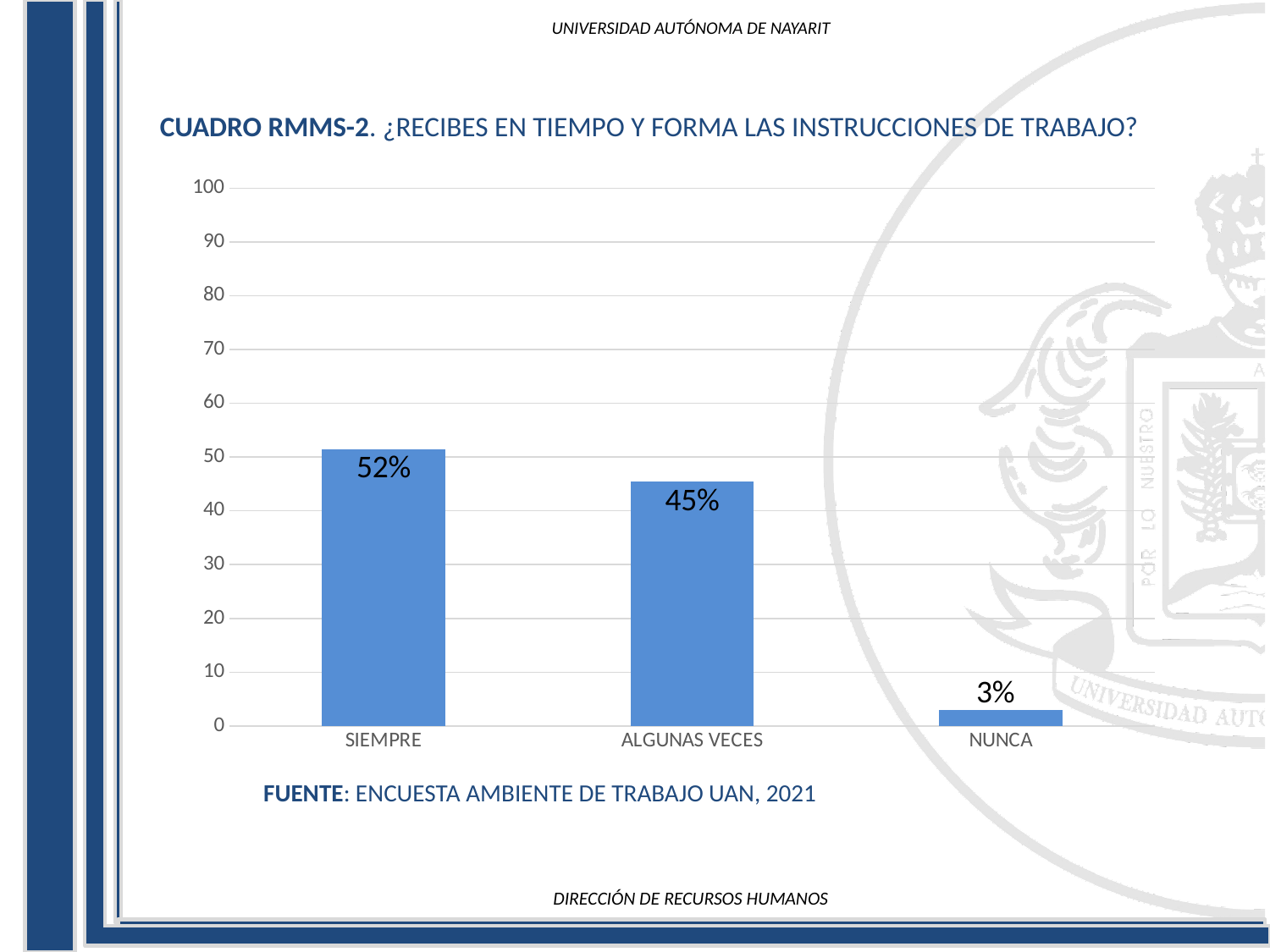
What is the value for ALGUNAS VECES? 45% What is the difference between the values for ALGUNAS VECES and NUNCA? 42% How many categories are shown on the x axis? 3 What is the value for NUNCA? 3% What source is cited below the chart? ENCUESTA AMBIENTE DE TRABAJO UAN, 2021 What is the difference between the values for SIEMPRE and ALGUNAS VECES? 7% Is the value for ALGUNAS VECES greater or less than 50? less What is the value for SIEMPRE? 52% What kind of chart is shown on the slide? bar chart Which category has the highest value? SIEMPRE Which category has the lowest value? NUNCA Which is larger, the value for SIEMPRE or the value for NUNCA? SIEMPRE